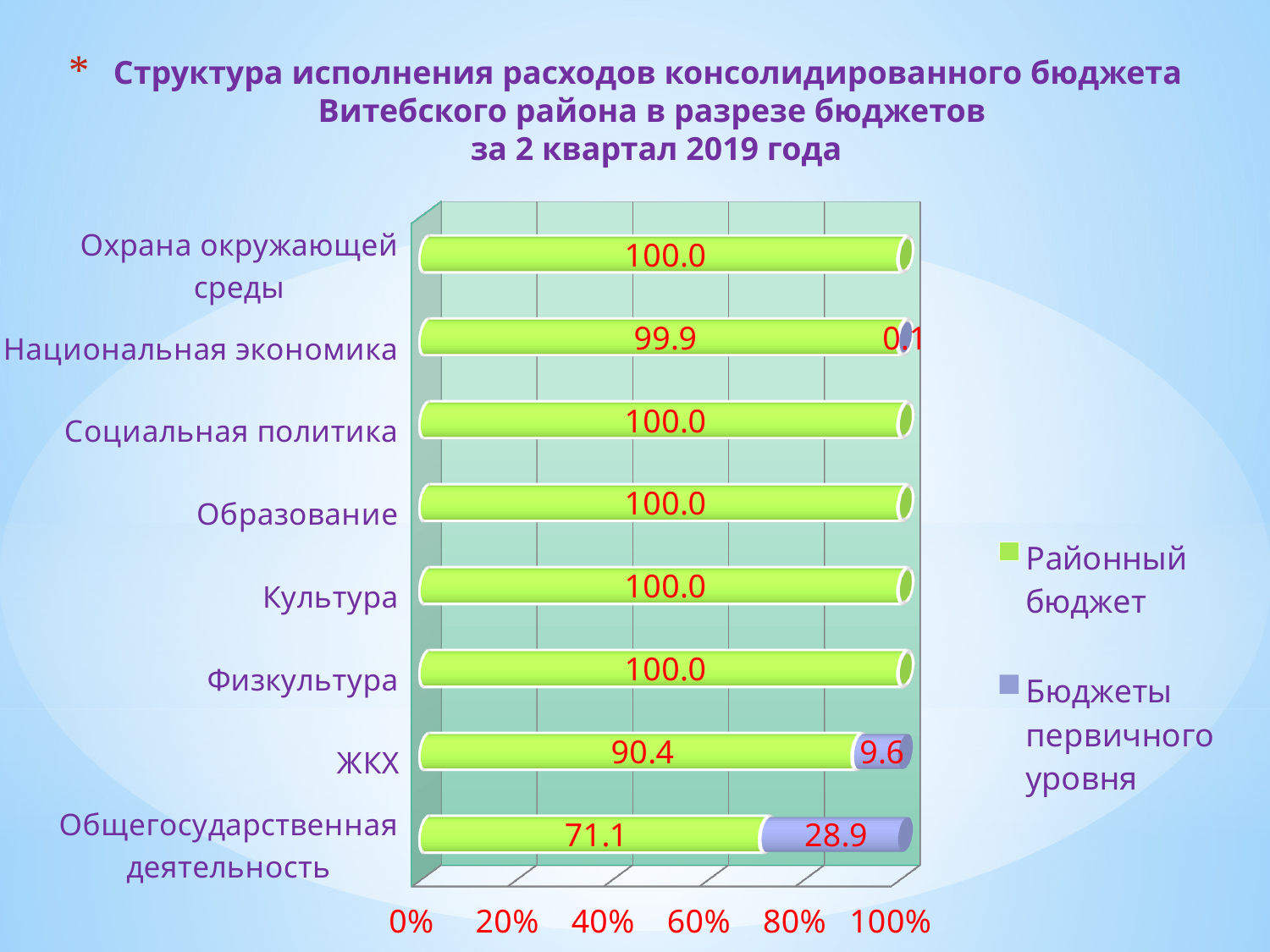
How many series does the legend list? 2 What is the value for Бюджеты первичного уровня in the ЖКХ category? 9.6 Which category has the lowest value for Районный бюджет? Общегосударственная деятельность How many categories are shown on the chart? 8 What is the total of the stacked bar for Общегосударственная деятельность? 100.0 Which category has the highest value for Бюджеты первичного уровня? Общегосударственная деятельность What is the value for Районный бюджет in the Национальная экономика category? 99.9 Which is larger: the Районный бюджет value for ЖКХ or for Общегосударственная деятельность? ЖКХ What is the difference between the Районный бюджет values for ЖКХ and Общегосударственная деятельность? 19.3 What kind of chart is shown on the slide? Stacked bar chart What is the value for Бюджеты первичного уровня in the Общегосударственная деятельность category? 28.9 What is the value for Районный бюджет in the ЖКХ category? 90.4